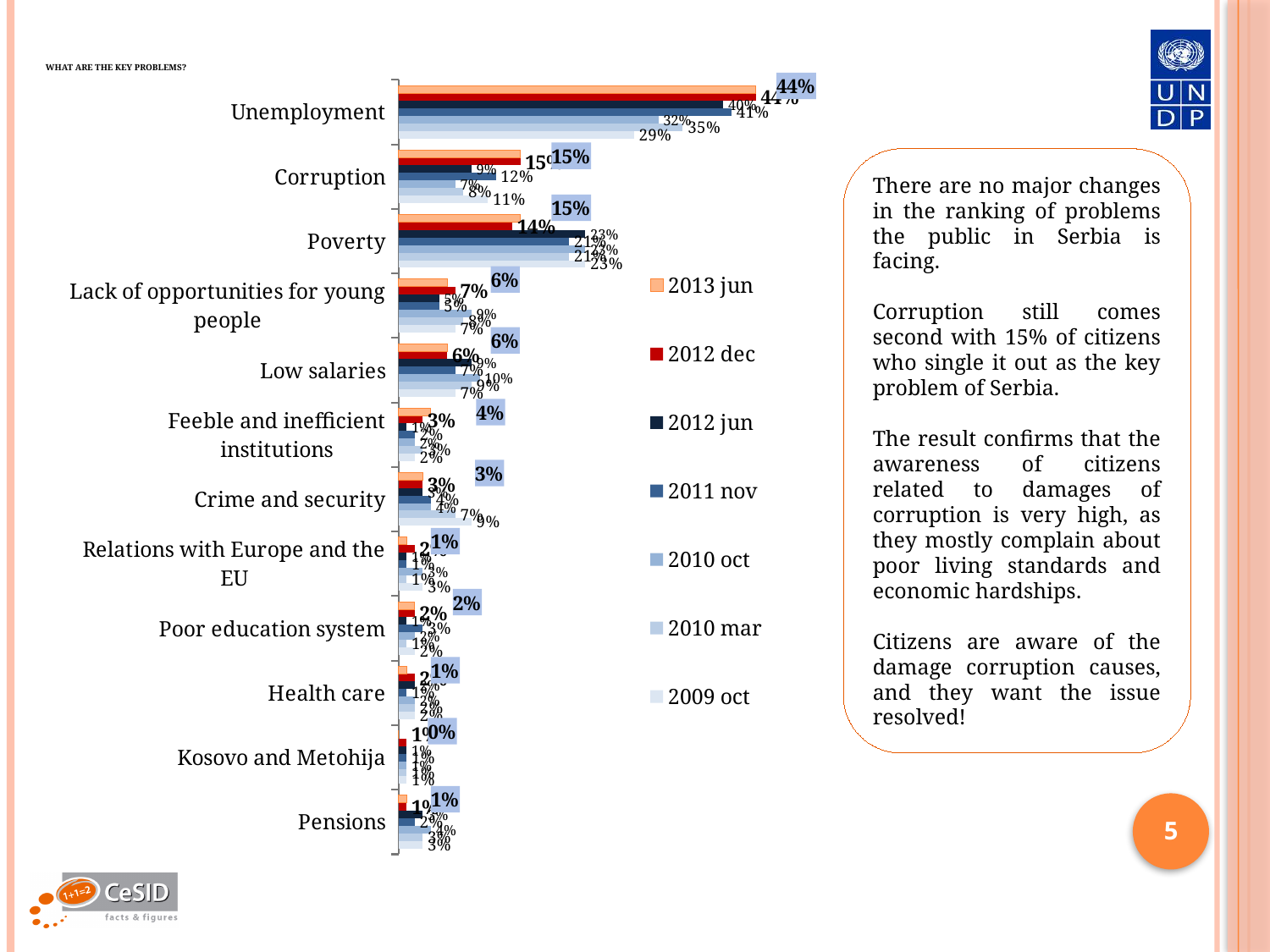
What is the value for Unemployment in 2013 jun? 44% What is the difference between the 2013 jun values for Unemployment and Corruption? 29 percentage points How many series does the chart's legend list? 7 What is the value for Poverty in 2012 dec? 14% What is the value for Corruption in 2013 jun? 15% Which problem has the highest value for 2013 jun? Unemployment What is the value for Lack of opportunities for young people in 2012 dec? 7% What is the value for Feeble and inefficient institutions in 2013 jun? 4% What kind of chart is shown on the slide? Bar chart Which has the larger 2013 jun value, Unemployment or Poverty? Unemployment How many problem categories are listed on the chart? 12 What is the title of the chart? WHAT ARE THE KEY PROBLEMS?